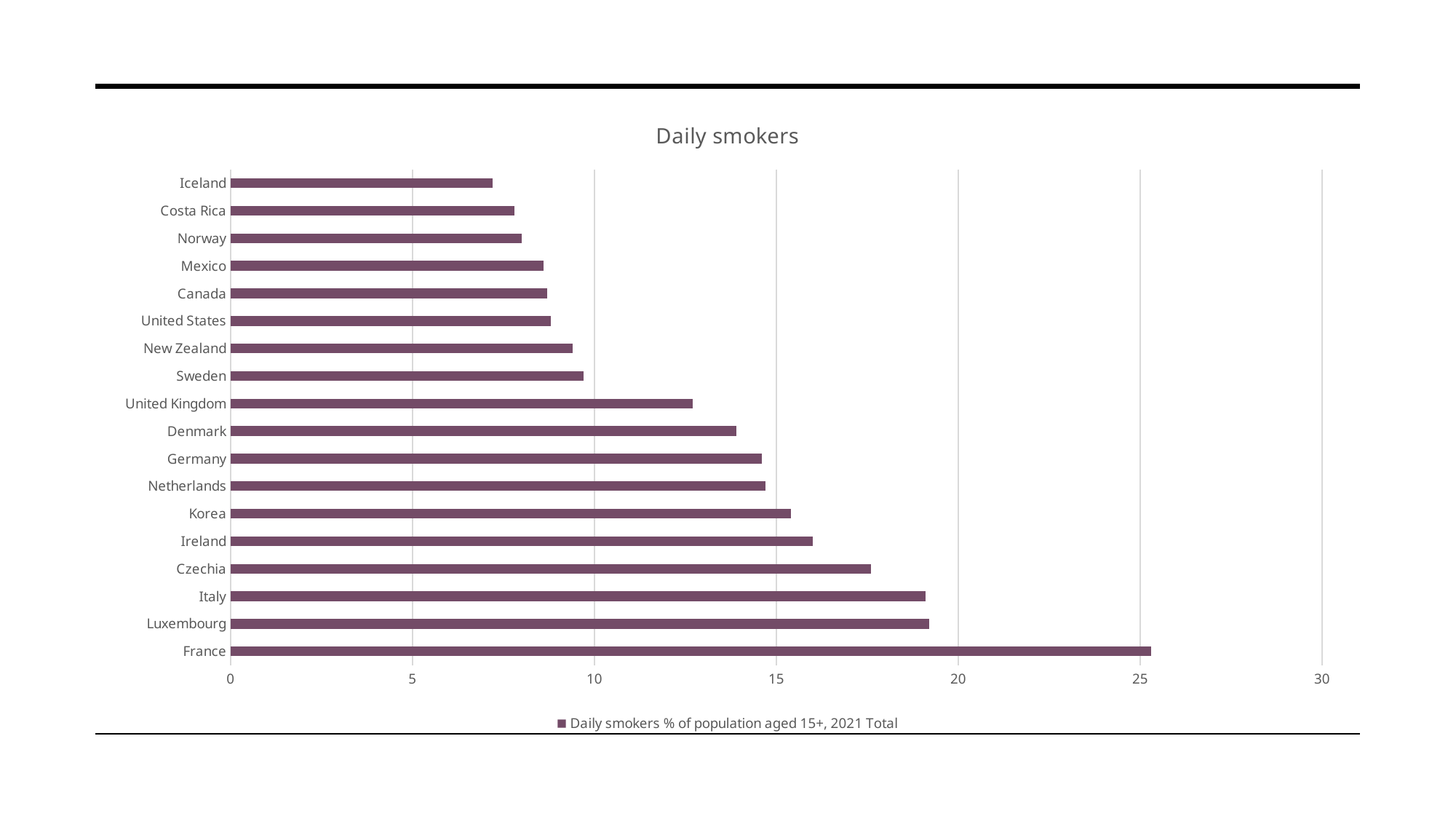
How many countries are plotted in the chart? 18 What is the title of the chart? Daily smokers What kind of chart is shown on the slide? Bar chart Which has the larger value, Czechia or Ireland? Czechia Which country has the lowest value in the chart? Iceland Is the value for Czechia greater or less than 15? greater Is the value for France greater or less than 20? greater Is the value for Sweden greater or less than 10? less Which has the larger value, the United Kingdom or Sweden? United Kingdom What is the legend entry for the series in the chart? Daily smokers % of population aged 15+, 2021 Total Which country has the highest value in the chart? France How many series does the legend list? 1